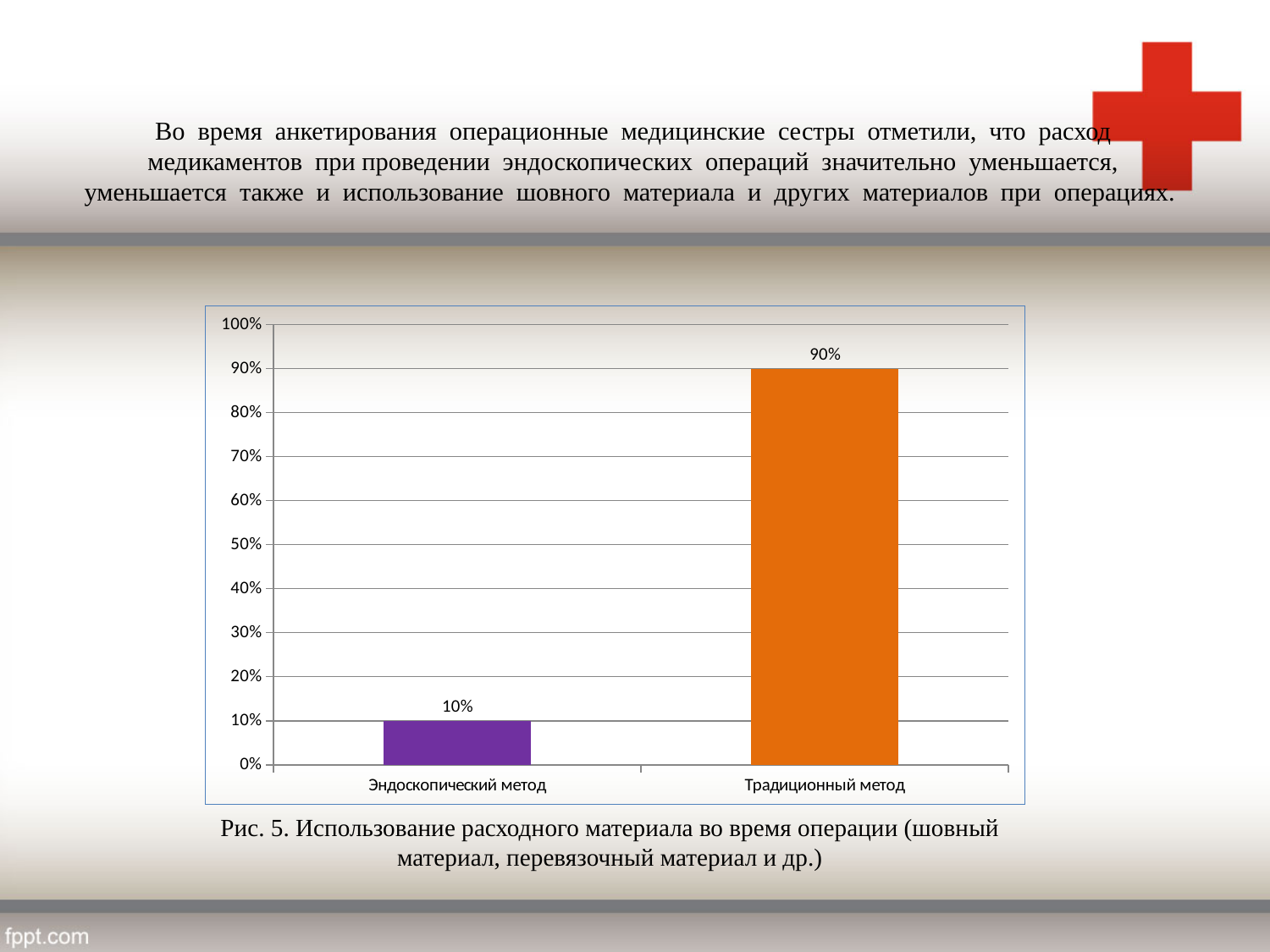
What colour is the bar for Традиционный метод? orange What kind of chart is shown on the slide? bar chart Is the value for Традиционный метод greater or less than 50%? greater Which is larger, the value for Эндоскопический метод or the value for Традиционный метод? Традиционный метод Which category has the highest value? Традиционный метод What is the total of the two bar values? 100% What is the value for Эндоскопический метод? 10% What is the difference between the values for Традиционный метод and Эндоскопический метод? 80% Which category has the lowest value? Эндоскопический метод How many categories are shown on the x axis? 2 What is the value for Традиционный метод? 90% Is the value for Эндоскопический метод greater or less than 20%? less